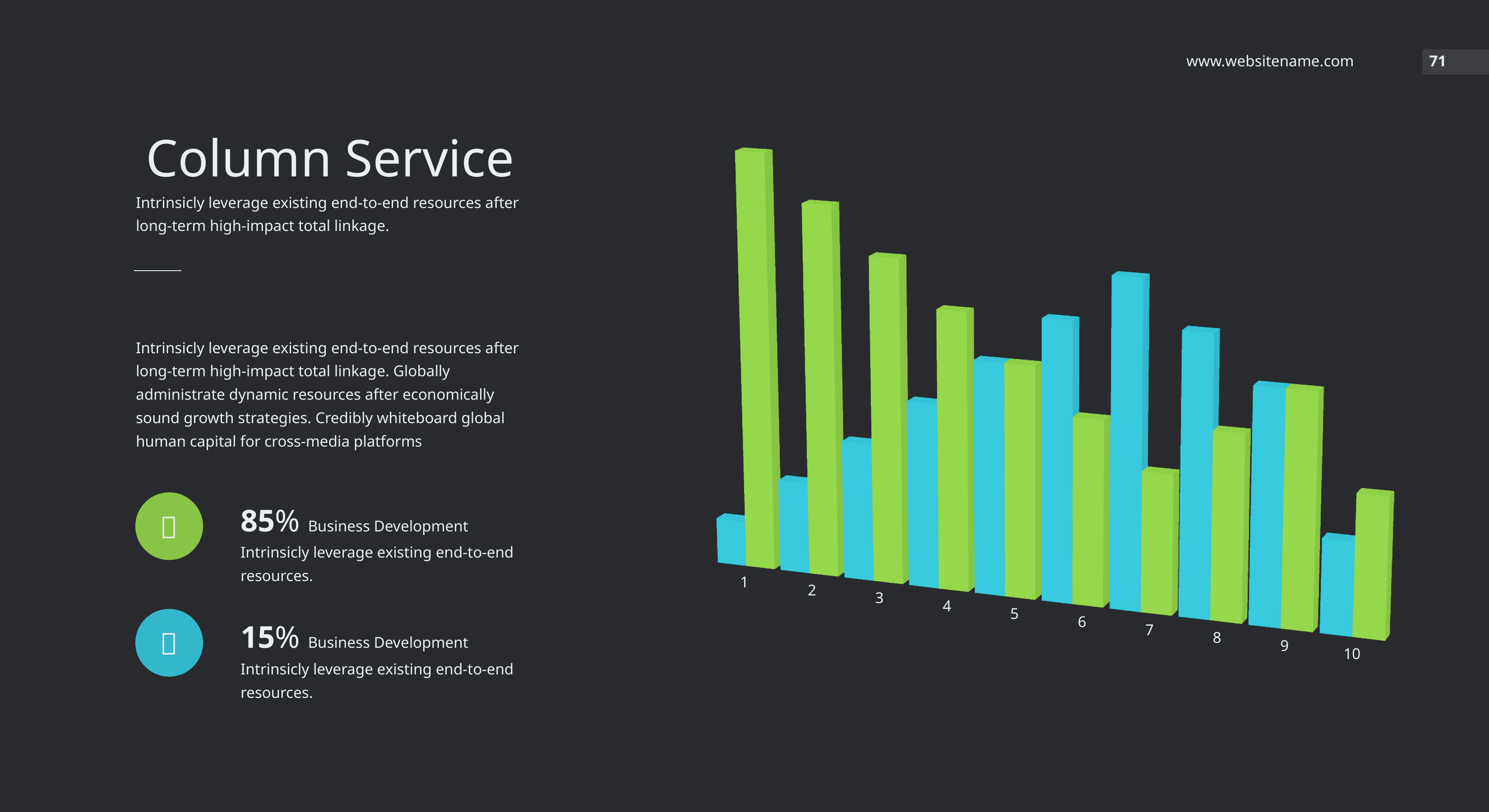
At category 10, which bar is taller, the green one or the blue one? green What is the title of the slide containing the chart? Column Service Which category has the tallest blue bar? 7 At category 7, which bar is taller, the green one or the blue one? blue Which category has the shortest blue bar? 1 How many categories are shown on the x axis of the chart? 10 At category 1, which bar is taller, the green one or the blue one? green Do the green bars rise or fall from category 1 to category 6? fall Do the blue bars rise or fall from category 1 to category 7? rise How many data series are plotted in the chart? 2 What kind of chart is shown on the slide? bar chart Which category has the tallest green bar? 1